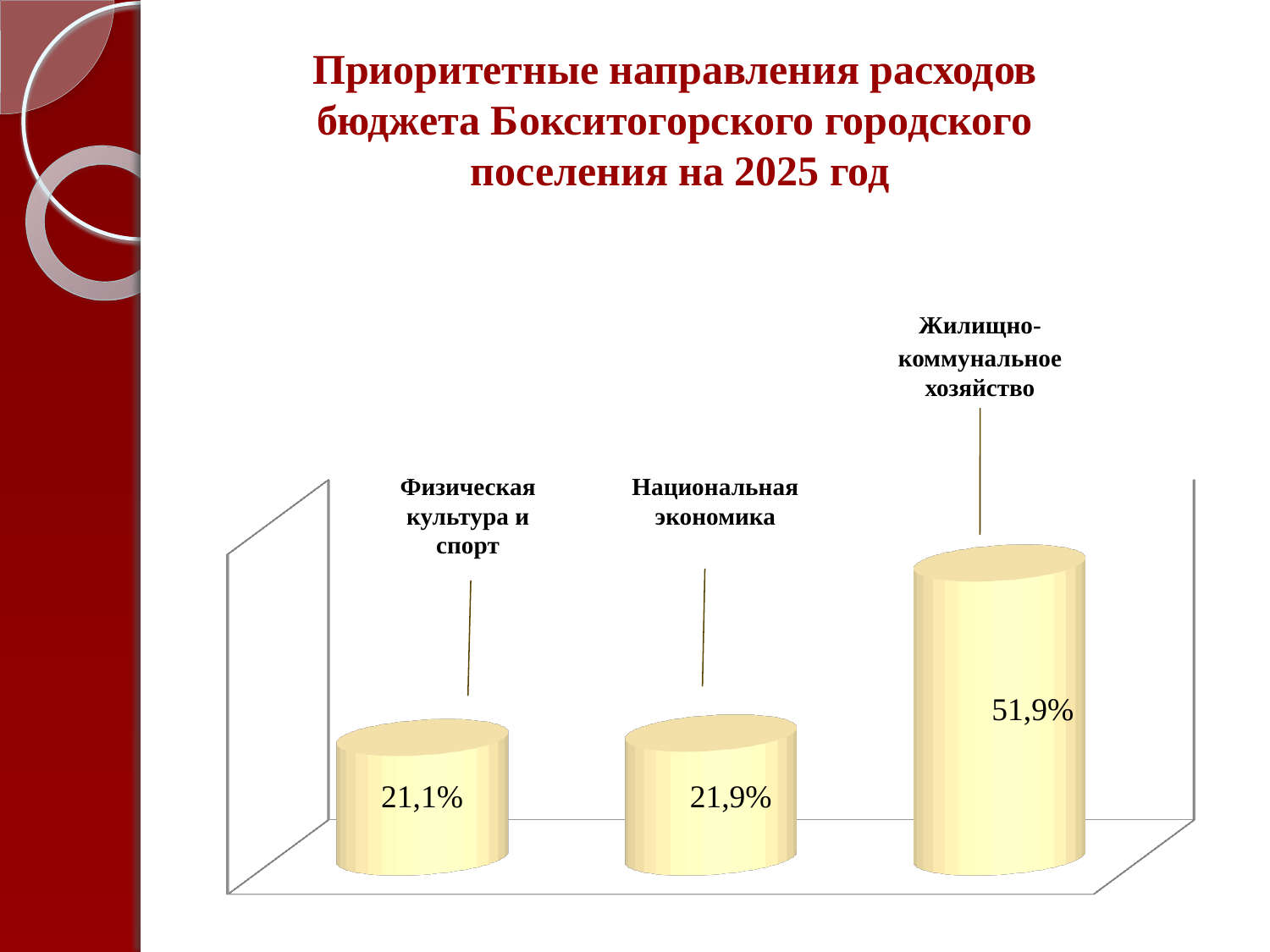
Which category has the lowest value? Физическая культура и спорт How many categories are shown in the chart? 3 What is the difference between the values for Национальная экономика and Физическая культура и спорт? 0,8% What is the difference between the values for Жилищно-коммунальное хозяйство and Национальная экономика? 30,0% Do the values rise or fall from left to right along the x axis? Rise Which category has the highest value? Жилищно-коммунальное хозяйство What is the value for Жилищно-коммунальное хозяйство? 51,9% What is the value for Физическая культура и спорт? 21,1% What is the value for Национальная экономика? 21,9% Which is larger, the value for Жилищно-коммунальное хозяйство or the value for Физическая культура и спорт? Жилищно-коммунальное хозяйство What kind of chart is shown on the slide? Bar chart What is the title of the slide? Приоритетные направления расходов бюджета Бокситогорского городского поселения на 2025 год